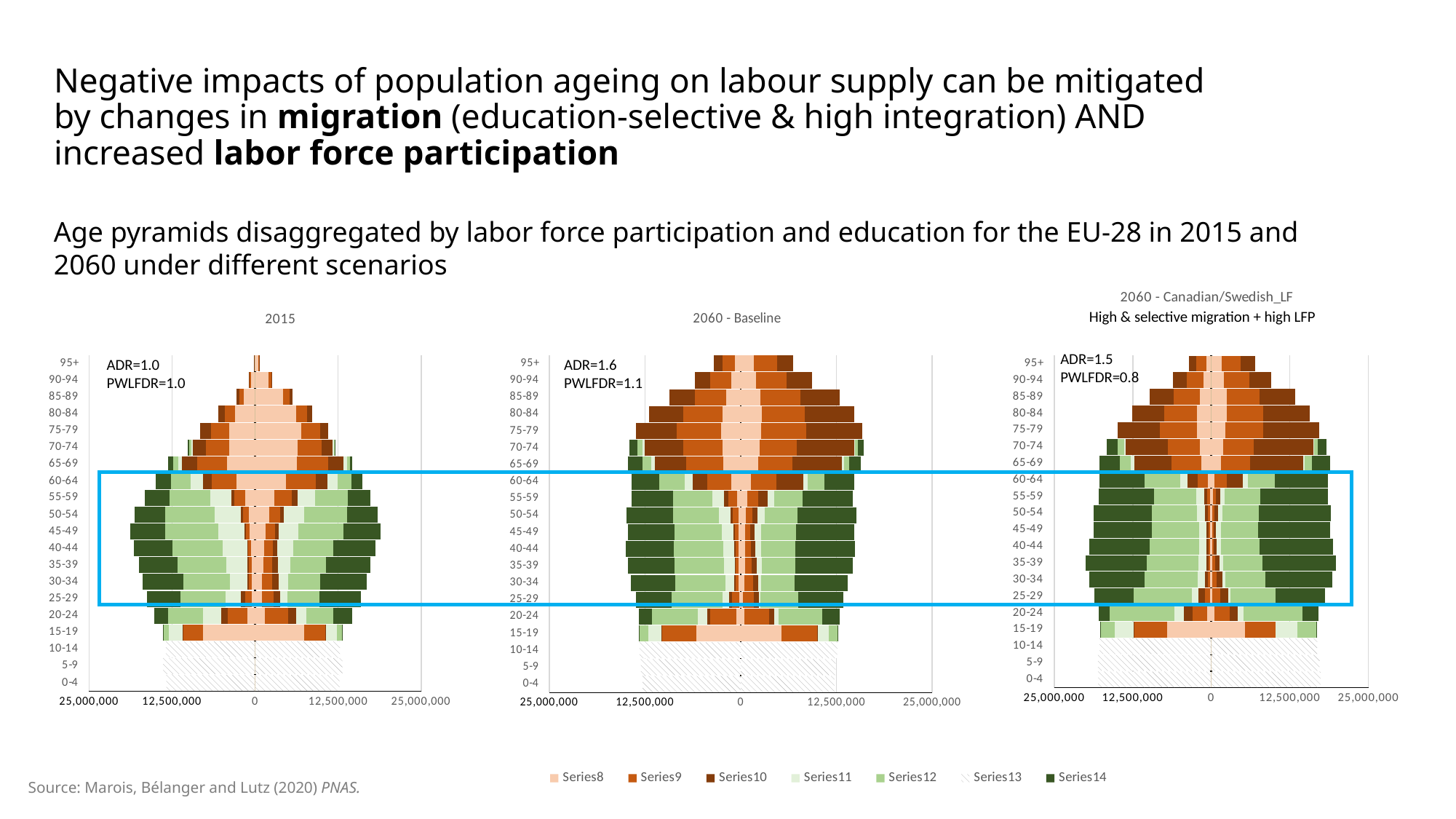
What ADR value is printed on the 2015 chart? ADR=1.0 What PWLFDR value is printed on the 2060 - Baseline chart? PWLFDR=1.1 How many series does the legend list? 7 In the 2015 chart, do the bars get longer or shorter moving down from 95+ to 45-49? longer What PWLFDR value is printed on the 2060 - Canadian/Swedish_LF chart? PWLFDR=0.8 What ADR value is printed on the 2060 - Canadian/Swedish_LF chart? ADR=1.5 In the 2015 chart, is the right-hand bar for the 95+ age group greater or less than 12,500,000? less How many age groups are shown on the vertical axis of the 2060 - Baseline chart? 20 In the 2015 chart, is the right-hand bar for the 45-49 age group greater or less than 12,500,000? greater What kind of chart is the 2015 chart? bar chart What is the title of the middle chart? 2060 - Baseline In the 2060 - Baseline chart, which bar is longer: the one for 45-49 or the one for 95+? 45-49